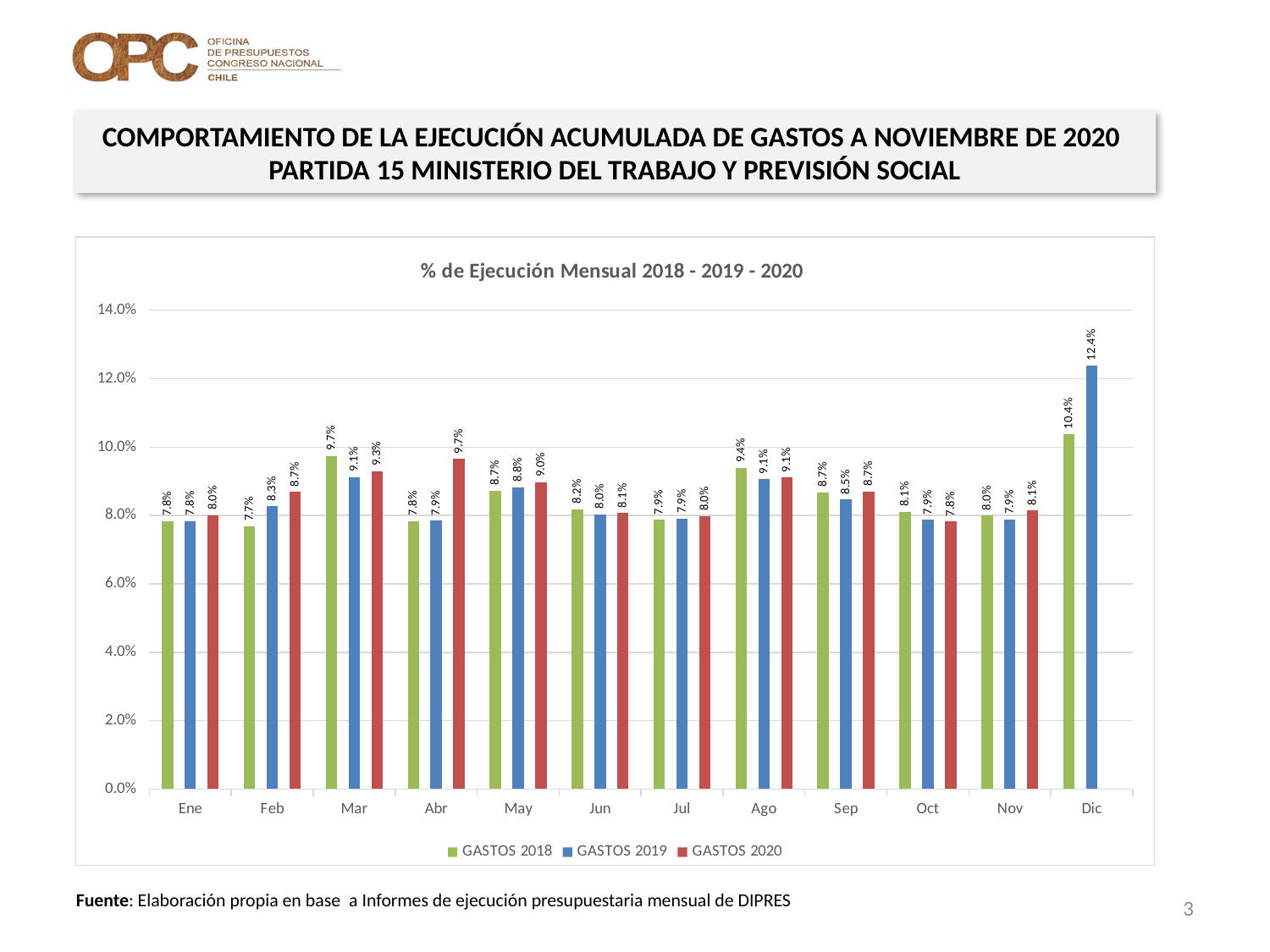
How many months are shown on the x axis? 12 Which is larger in Abr: GASTOS 2020 or GASTOS 2018? GASTOS 2020 What is the value for GASTOS 2020 in Abr? 9.7% In which month is the GASTOS 2020 value lowest? Oct How many series does the legend list? 3 What is the difference between the GASTOS 2019 and GASTOS 2018 values in Dic? 2.0% Is the value for GASTOS 2019 in Dic greater or less than 12.0%? greater What kind of chart is shown on the slide? Bar chart What is the value for GASTOS 2018 in Mar? 9.7% What is the value for GASTOS 2019 in Dic? 12.4% What is the value for GASTOS 2020 in Feb? 8.7% In which month is the GASTOS 2018 value highest? Dic